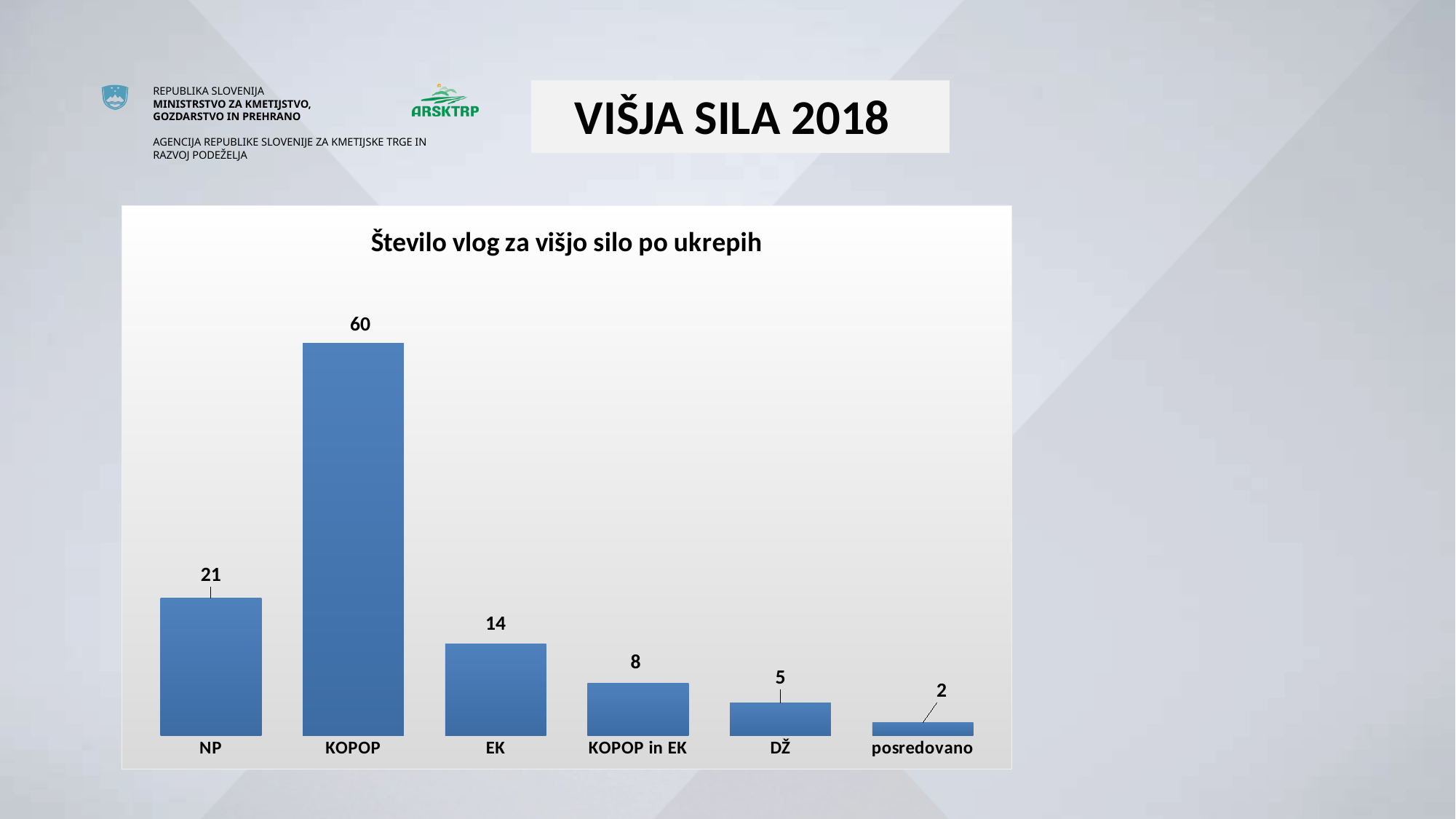
What is the value for posredovano? 2 Which category has the highest value? KOPOP What is the value for KOPOP in EK? 8 What is the difference between the values for EK and DŽ? 9 What kind of chart is shown on the slide? bar chart How many categories are shown in the chart? 6 What is the difference between the values for KOPOP and NP? 39 Which is larger, the value for EK or the value for KOPOP in EK? EK What is the value for KOPOP? 60 What is the title of the chart? Število vlog za višjo silo po ukrepih What is the value for NP? 21 Which category has the lowest value? posredovano